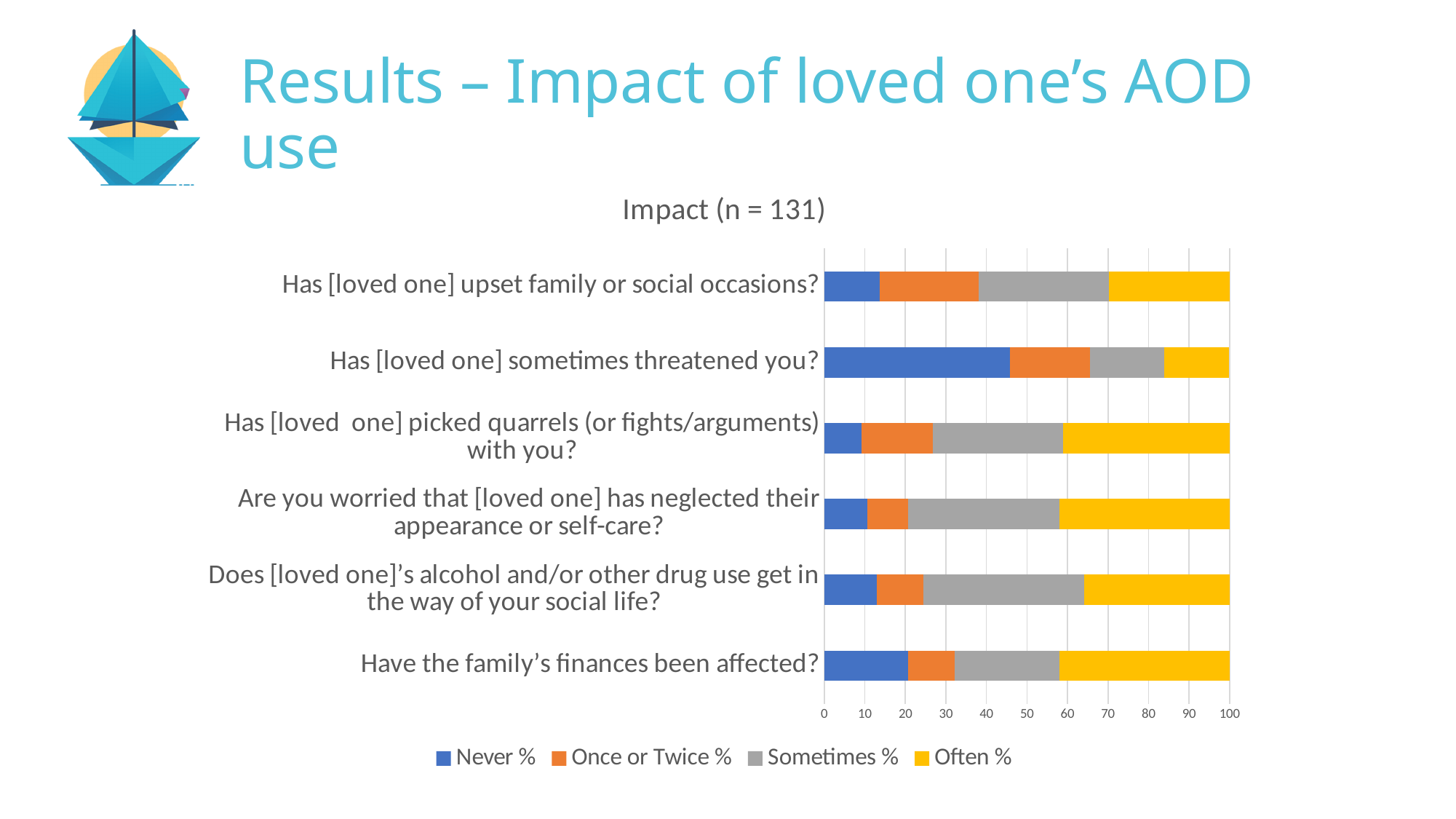
Is the 'Never %' value for 'Has [loved one] sometimes threatened you?' greater or less than 40? greater How many survey questions (categories) are plotted in the chart? 6 Which has the larger 'Never %' value: 'Has [loved one] sometimes threatened you?' or 'Have the family's finances been affected?' Has [loved one] sometimes threatened you? Is the 'Never %' value for 'Has [loved one] upset family or social occasions?' greater or less than 20? less How many series does the legend list? 4 What is the total of the stacked bar for 'Have the family's finances been affected?' 100 Which category has the largest 'Never %' segment? Has [loved one] sometimes threatened you? Is the 'Often %' value for 'Has [loved one] picked quarrels (or fights/arguments) with you?' greater or less than 30? greater What kind of chart is shown on the slide? Stacked bar chart Which category has the smallest 'Often %' segment? Has [loved one] sometimes threatened you? Which colour represents the 'Often %' series in the chart? Yellow What is the title of the chart? Impact (n = 131)